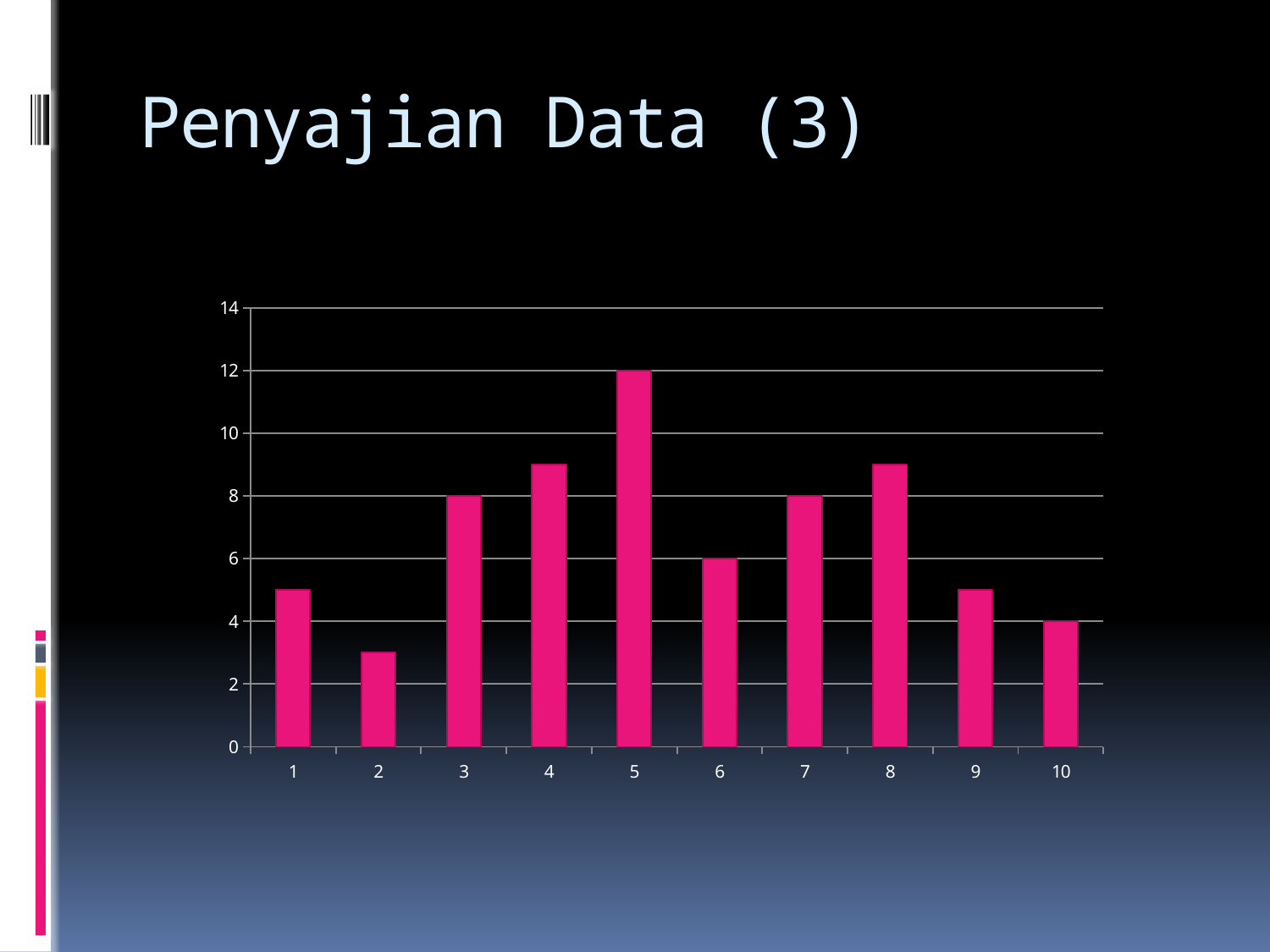
What is the title of the slide? Penyajian Data (3) What is the value for category 6? 6 Is the value for category 1 greater or less than 6? less Is the value for category 4 greater or less than 8? greater What is the difference between the values for category 5 and category 6? 6 Which category has the lowest value? 2 What kind of chart is shown on the slide? bar chart What is the value for category 10? 4 Which category has the highest value? 5 Which has the larger value, category 3 or category 10? 3 How many categories are shown on the x axis? 10 What is the value for category 5? 12